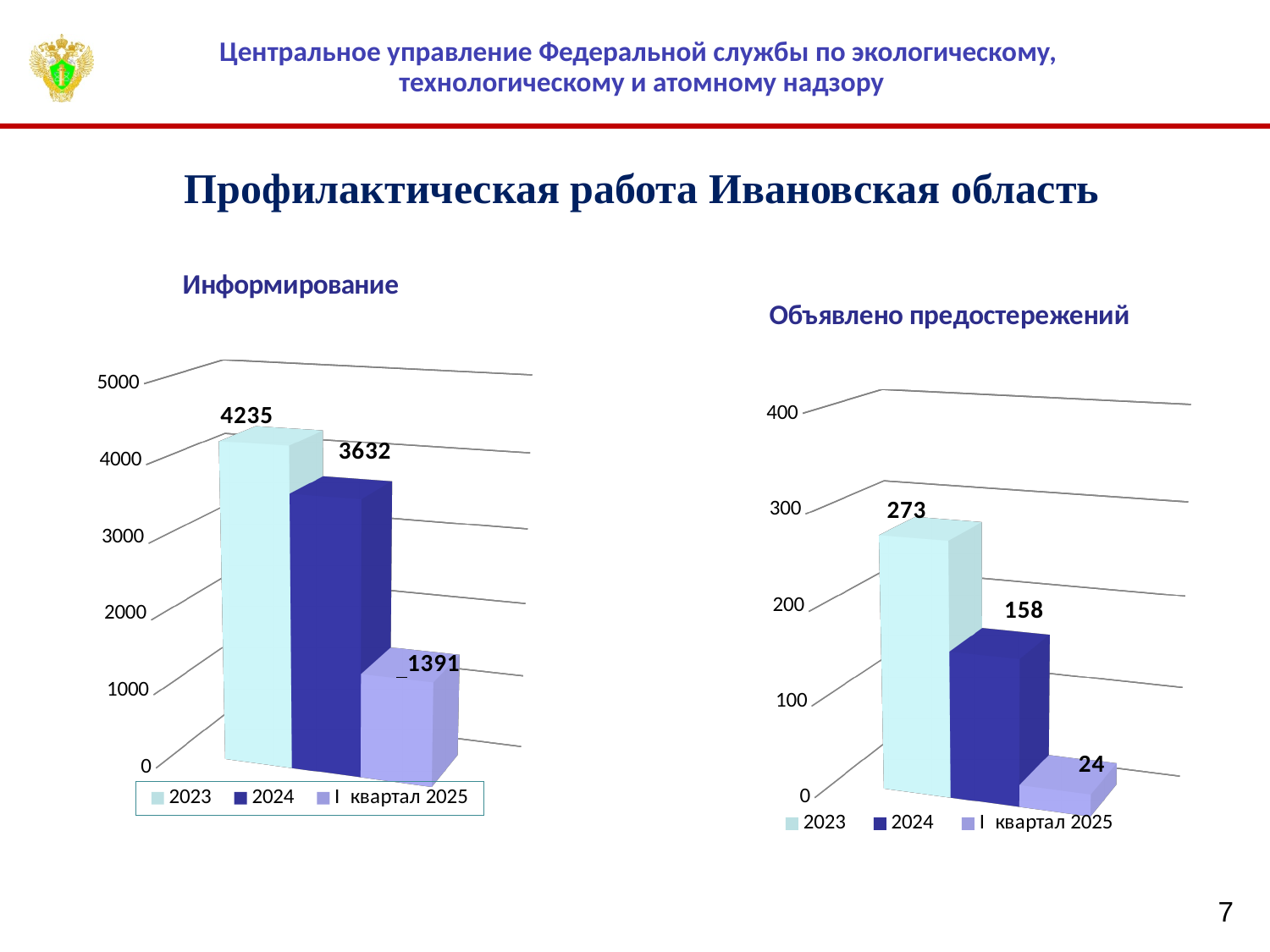
In the 'Объявлено предостережений' chart, what is the value for 2023? 273 In the 'Информирование' chart, what is the value for 2023? 4235 In the 'Объявлено предостережений' chart, which series has the lowest value? I квартал 2025 In the 'Информирование' chart, what is the value for I квартал 2025? 1391 How many series does the legend of the 'Информирование' chart list? 3 In the 'Объявлено предостережений' chart, what is the value for I квартал 2025? 24 In the 'Информирование' chart, what is the value for 2024? 3632 In the 'Объявлено предостережений' chart, is the value for 2024 greater or less than 200? less What kind of chart is the 'Объявлено предостережений' chart? bar chart In the 'Информирование' chart, what is the difference between the 2023 and 2024 values? 603 In the 'Информирование' chart, which series has the highest value? 2023 In the 'Объявлено предостережений' chart, what is the difference between the 2023 and 2024 values? 115